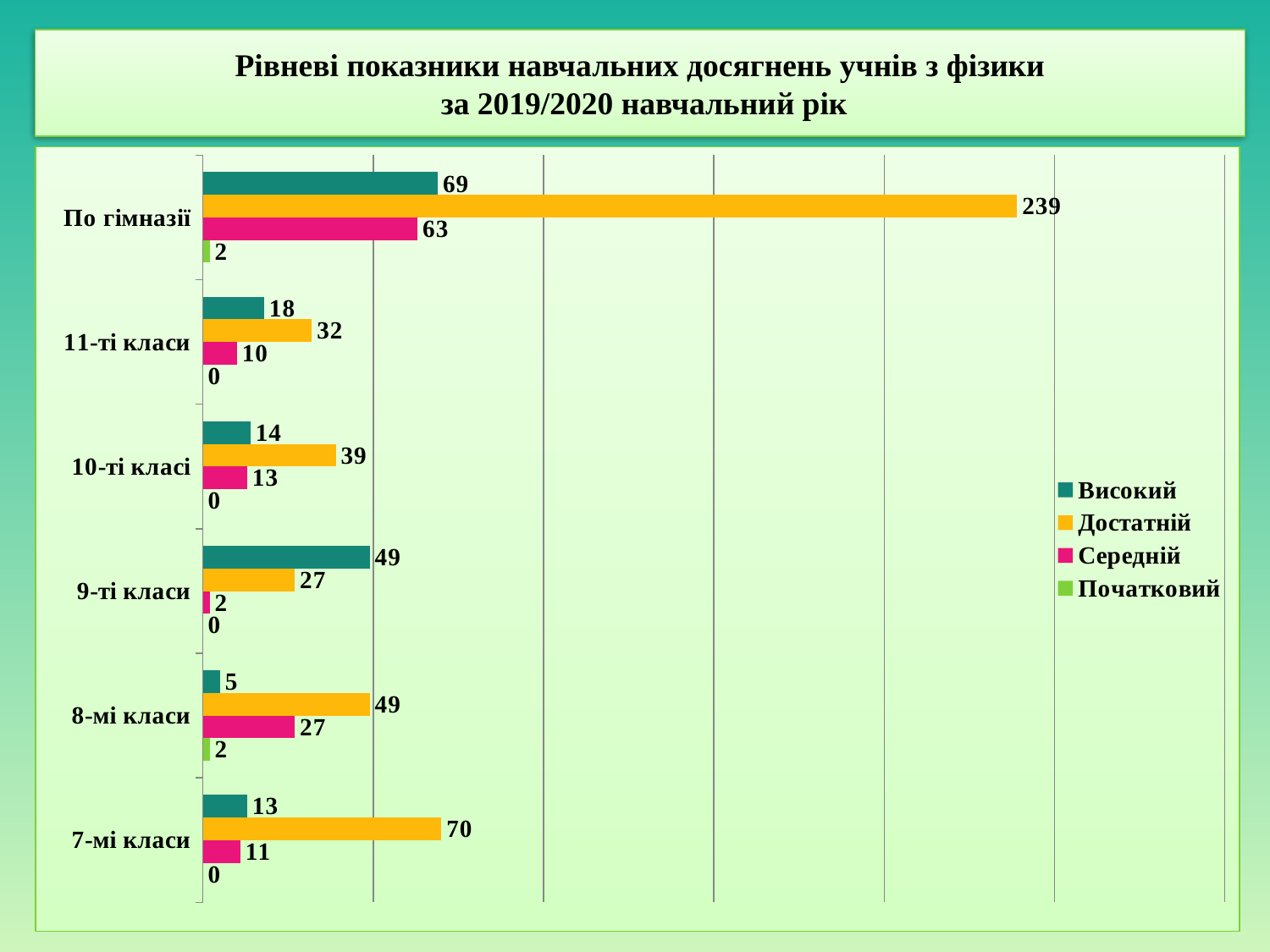
Which class category (excluding По гімназії) has the lowest Високий value? 8-мі класи Which is larger for 9-ті класи: Високий or Достатній? Високий What is the difference between the Достатній and Високий values for 7-мі класи? 57 Which legend entry is shown in green? Початковий How many categories are shown on the y axis? 6 How many series does the legend list? 4 Which category has the highest Достатній value? По гімназії What is the value of Початковий for 11-ті класи? 0 What kind of chart is shown on the slide? Bar chart What is the value of Високий for 9-ті класи? 49 What is the value of Середній for 8-мі класи? 27 What is the value of Достатній for По гімназії? 239